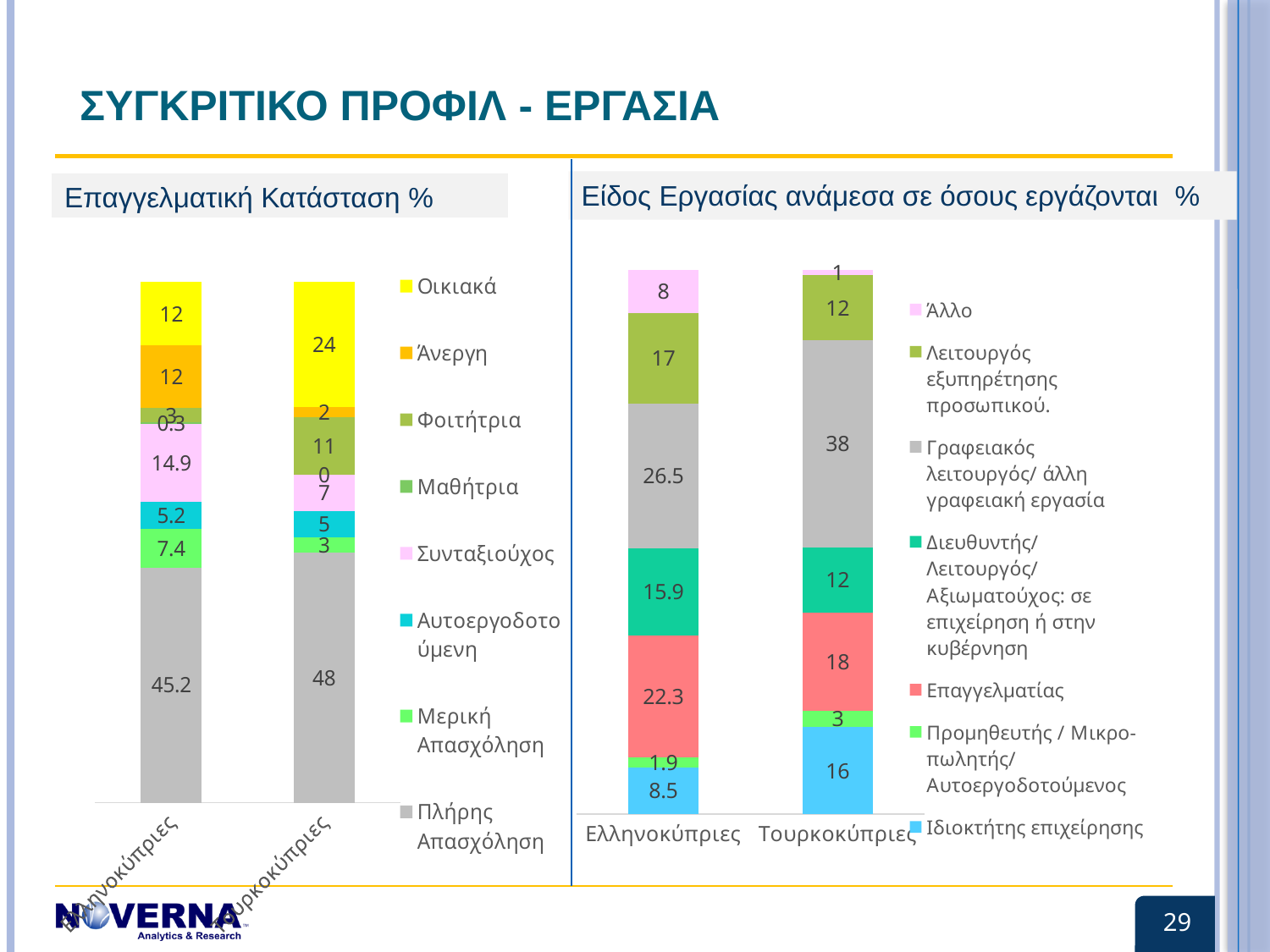
In the chart 'Είδος Εργασίας ανάμεσα σε όσους εργάζονται %', what is the value for Γραφειακός λειτουργός/ άλλη γραφειακή εργασία for Τουρκοκύπριες? 38 How many series does the legend of the chart 'Είδος Εργασίας ανάμεσα σε όσους εργάζονται %' list? 7 In the chart 'Είδος Εργασίας ανάμεσα σε όσους εργάζονται %', what is the value for Επαγγελματίας for Ελληνοκύπριες? 22.3 In the chart 'Επαγγελματική Κατάσταση %', what is the value for Οικιακά for Τουρκοκύπριες? 24 In the chart 'Επαγγελματική Κατάσταση %', what is the difference between the Πλήρης Απασχόληση values for Τουρκοκύπριες and Ελληνοκύπριες? 2.8 What kind of chart is 'Είδος Εργασίας ανάμεσα σε όσους εργάζονται %'? Stacked bar chart In the chart 'Είδος Εργασίας ανάμεσα σε όσους εργάζονται %', which segment is the largest in the Ελληνοκύπριες bar? Γραφειακός λειτουργός/ άλλη γραφειακή εργασία How many series does the legend of the chart 'Επαγγελματική Κατάσταση %' list? 8 In the chart 'Επαγγελματική Κατάσταση %', what is the value for Πλήρης Απασχόληση for Ελληνοκύπριες? 45.2 In the chart 'Επαγγελματική Κατάσταση %', which group has the larger value for Άνεργη, Ελληνοκύπριες or Τουρκοκύπριες? Ελληνοκύπριες In the chart 'Είδος Εργασίας ανάμεσα σε όσους εργάζονται %', what is the difference between the Ιδιοκτήτης επιχείρησης values for Τουρκοκύπριες and Ελληνοκύπριες? 7.5 In the chart 'Επαγγελματική Κατάσταση %', what is the value for Συνταξιούχος for Ελληνοκύπριες? 14.9